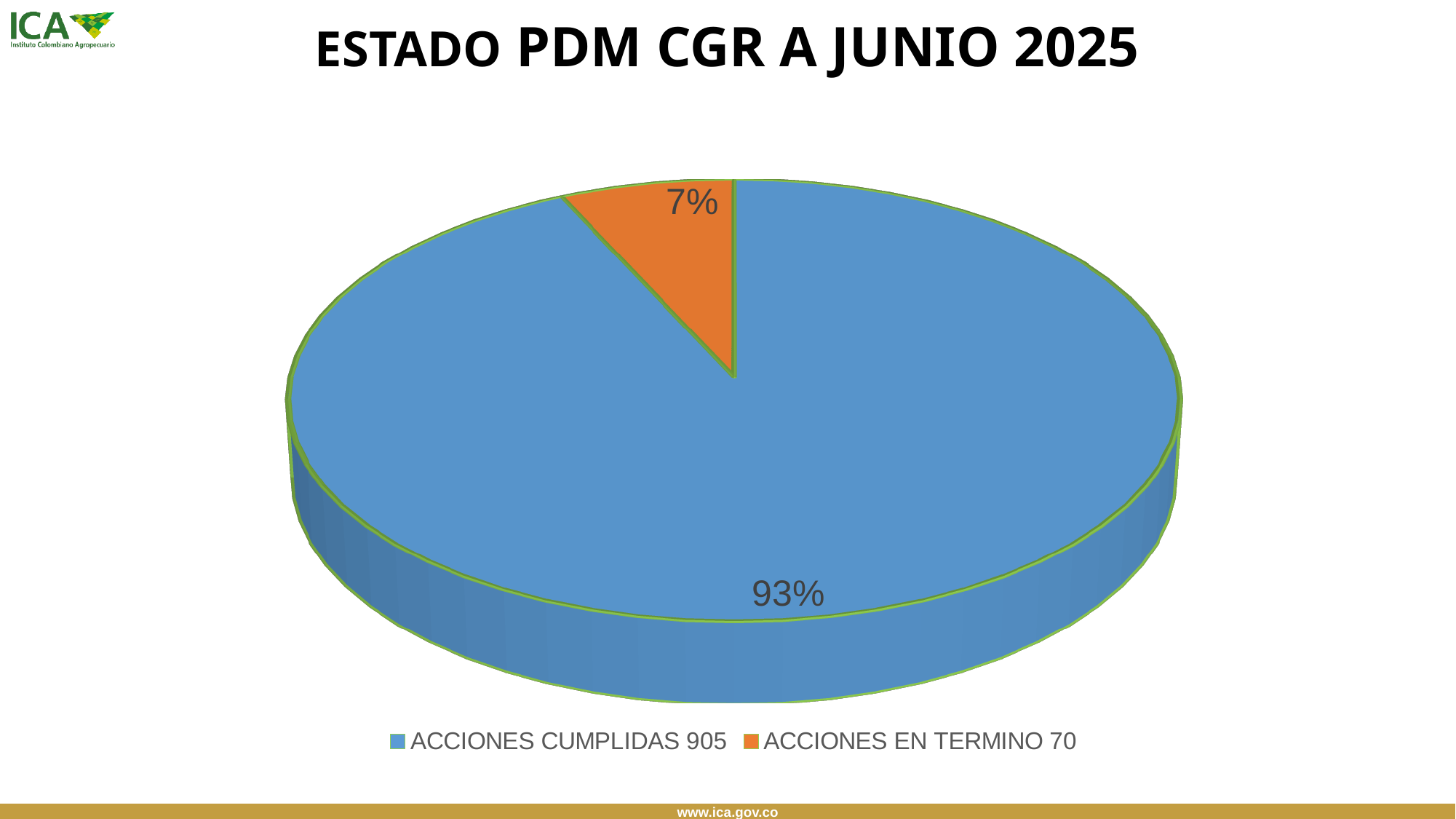
What colour is the ACCIONES EN TERMINO slice? Orange Which is larger, the ACCIONES CUMPLIDAS slice or the ACCIONES EN TERMINO slice? ACCIONES CUMPLIDAS How many slices does the pie chart have? 2 Which slice is the smallest in the pie chart? ACCIONES EN TERMINO 70 What is the title of the chart? ESTADO PDM CGR A JUNIO 2025 Which slice is the largest in the pie chart? ACCIONES CUMPLIDAS 905 What type of chart is shown on the slide? Pie chart What percentage share does the ACCIONES CUMPLIDAS slice have? 93% How many entries does the legend list? 2 What percentage share does the ACCIONES EN TERMINO slice have? 7% What is the difference in percentage points between the ACCIONES CUMPLIDAS slice and the ACCIONES EN TERMINO slice? 86 What count is shown in the legend for ACCIONES CUMPLIDAS? 905